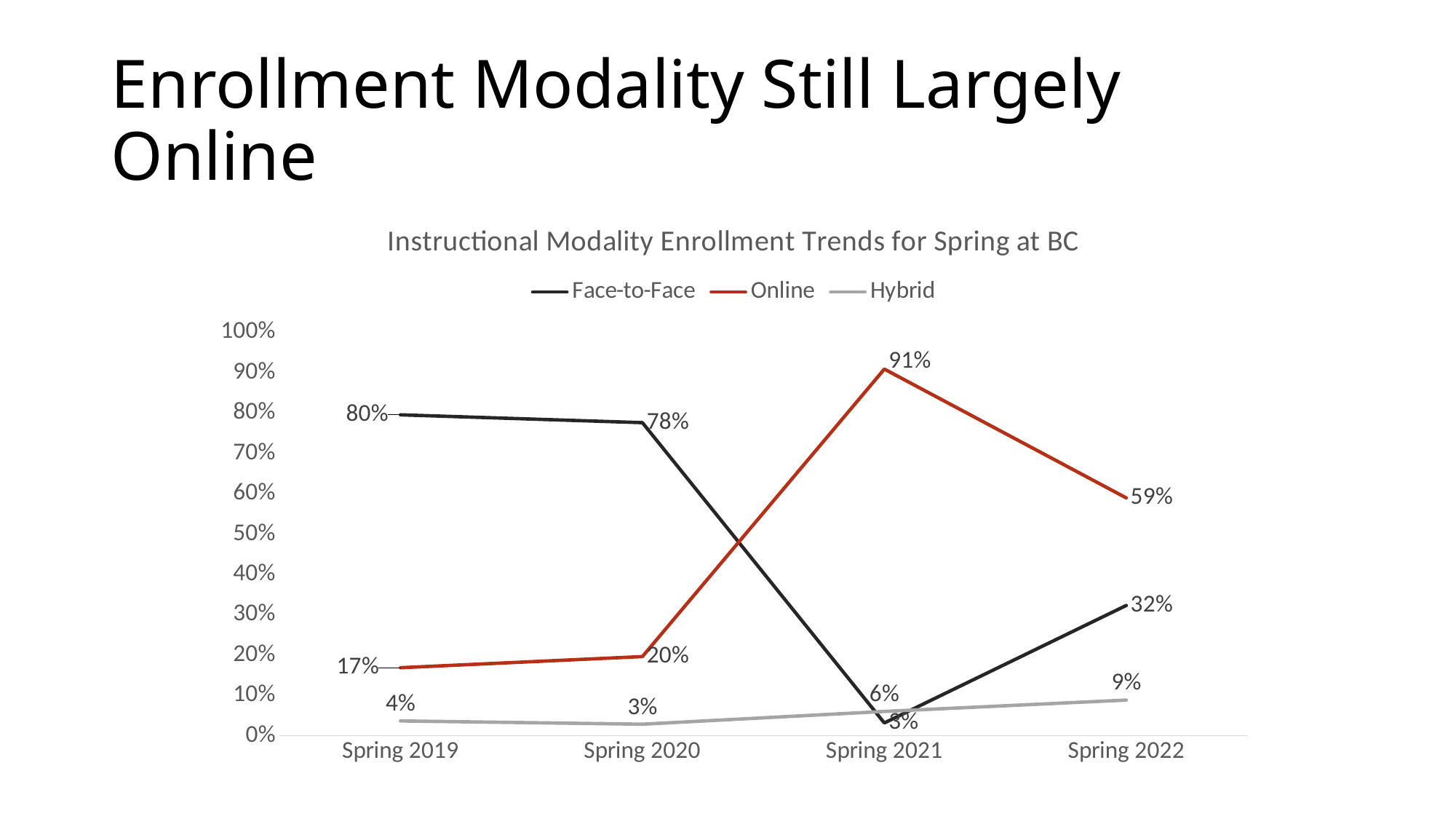
In which spring term is the Online value highest? Spring 2021 Which is larger in Spring 2022, the Online value or the Face-to-Face value? Online In which spring term is the Hybrid value lowest? Spring 2020 Does the Face-to-Face series rise or fall from Spring 2019 to Spring 2021? fall How many points are plotted along the x axis for each series? 4 What type of chart is shown on the slide? line chart What is the title of the chart? Instructional Modality Enrollment Trends for Spring at BC What is the Face-to-Face value for Spring 2019? 80% How many series does the legend list? 3 What is the difference between the Online values for Spring 2021 and Spring 2022? 32% What is the Online value for Spring 2021? 91% What is the Hybrid value for Spring 2022? 9%